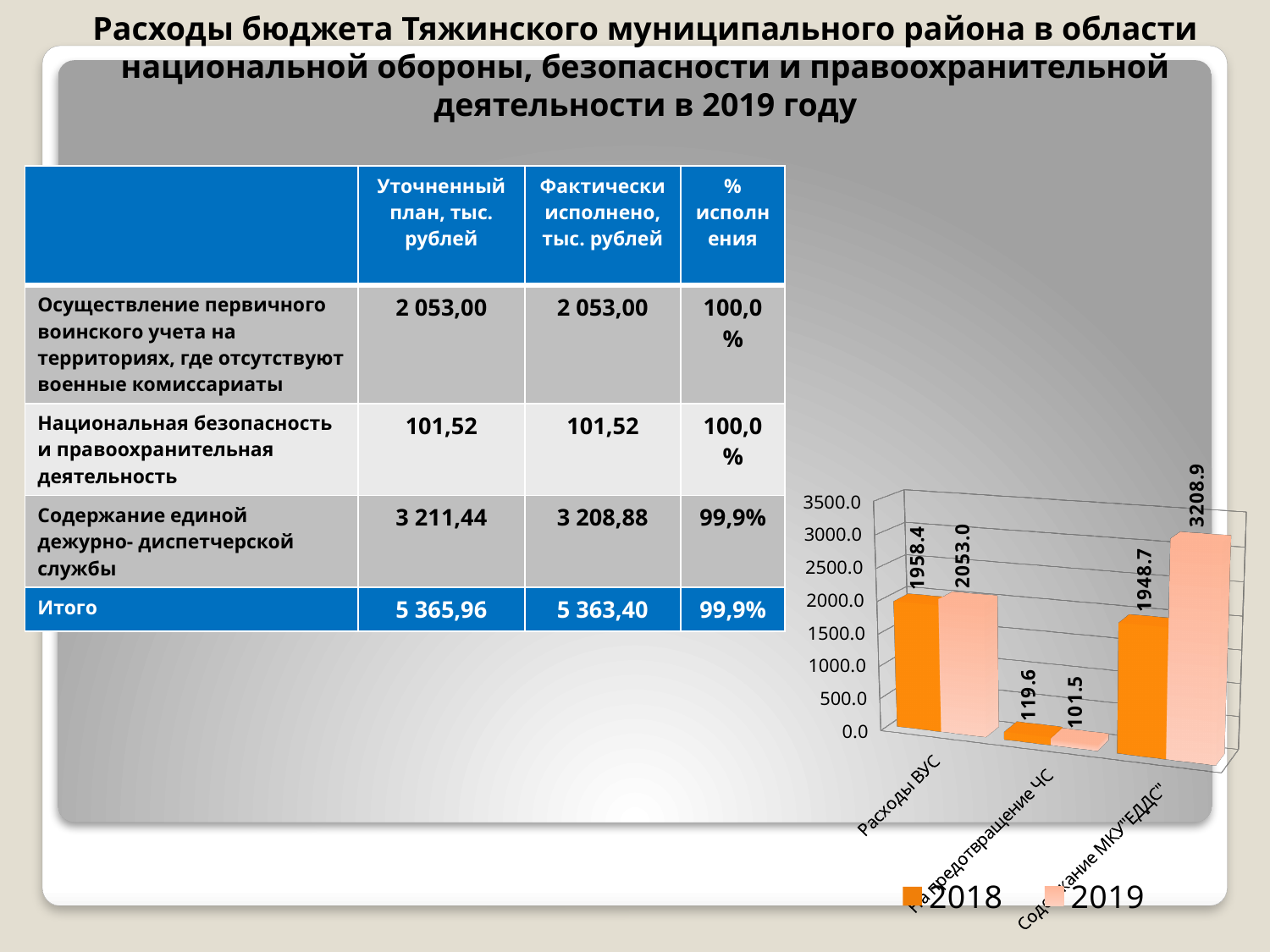
What is the 2019 value for Расходы ВУС in the chart? 2053.0 What is the difference between the 2019 and 2018 values for the МКУ "ЕДДС" category? 1260.2 How many series does the chart legend list? 2 What is the 2019 value for the предотвращение ЧС category in the chart? 101.5 What kind of chart is shown on the slide? bar chart What is the 2019 value for the МКУ "ЕДДС" category in the chart? 3208.9 Which series has the higher value for the МКУ "ЕДДС" category, 2018 or 2019? 2019 What is the 2018 value for Расходы ВУС in the chart? 1958.4 By how much does the 2019 value for Расходы ВУС exceed the 2018 value? 94.6 How many categories are shown on the chart's x axis? 3 What is the 2018 value for the МКУ "ЕДДС" category in the chart? 1948.7 Which category has the lowest 2019 value in the chart? предотвращение ЧС